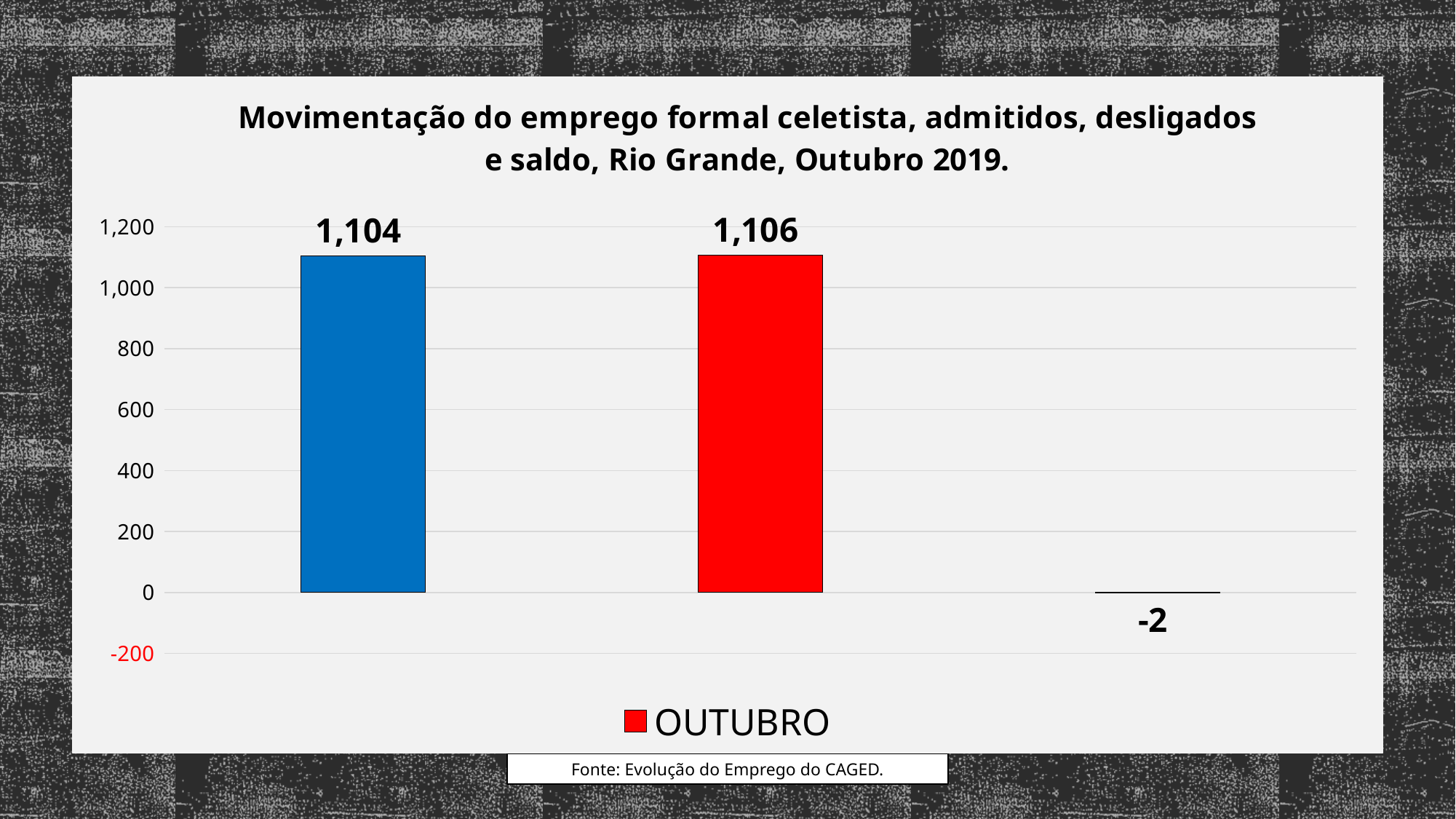
What is the value shown on the blue bar? 1,104 Which of the three plotted values is the highest? 1,106 How many data points are plotted in the chart? 3 What is the series name shown in the legend? OUTUBRO Which bar has the larger value, the blue bar or the red bar? the red bar Which of the three plotted values is the lowest? -2 What is the value of the third (rightmost) data point in the chart? -2 What kind of chart is shown on the slide? bar chart What is the difference between the red bar's value and the blue bar's value? 2 Is the value of the blue bar greater or less than 1,000? greater How many series does the legend list? 1 What is the value shown on the red bar? 1,106